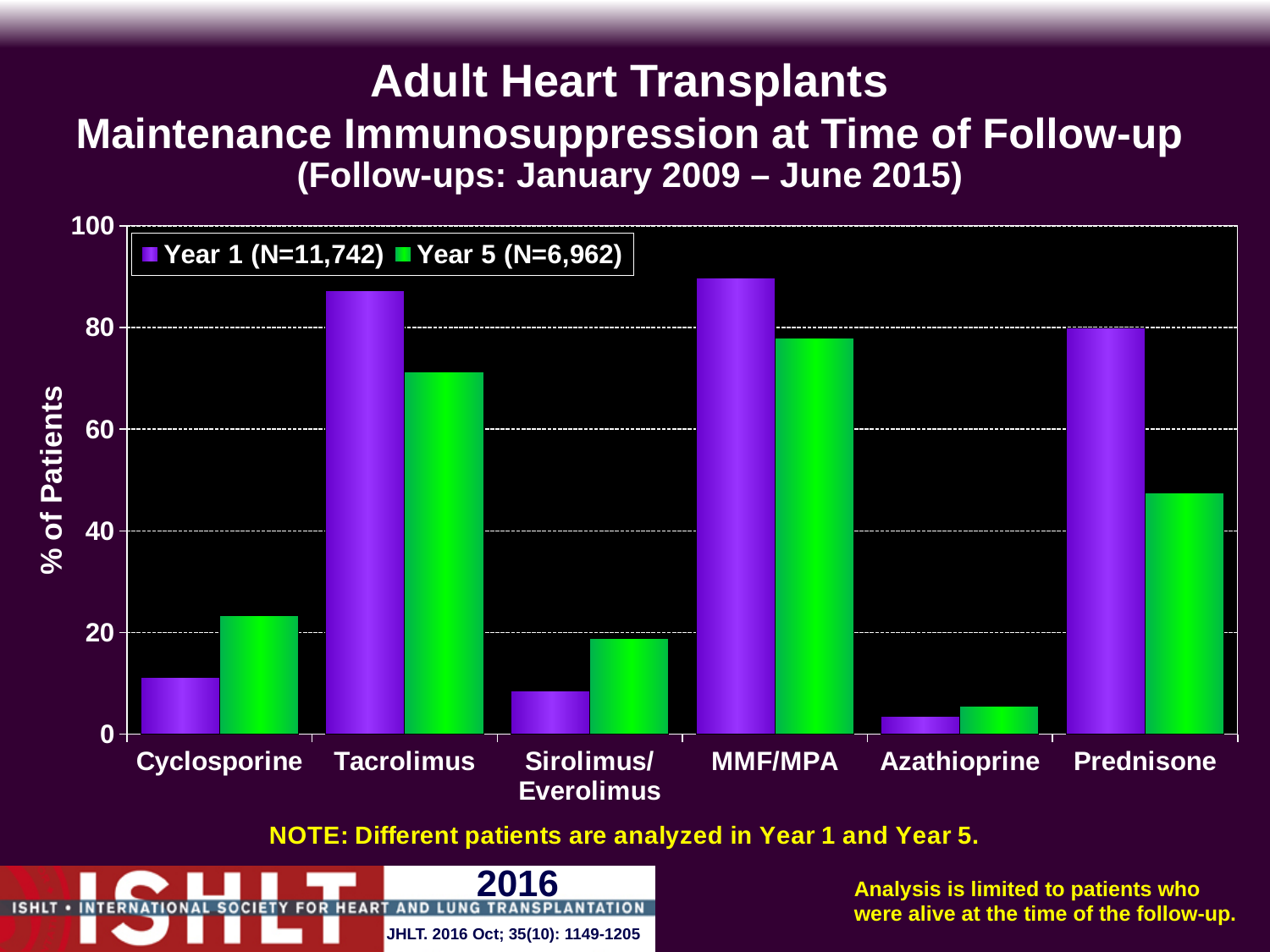
Which category has the highest Year 1 value? MMF/MPA Which category has the highest Year 5 value? MMF/MPA Which category has the lowest Year 1 value? Azathioprine How many series does the legend list? 2 Is the Year 1 value for Cyclosporine greater or less than 20? less For Prednisone, which is larger: the Year 1 value or the Year 5 value? Year 1 Which category has the lowest Year 5 value? Azathioprine What kind of chart is shown on the slide? bar chart How many drug categories are shown on the x axis? 6 Is the Year 5 value for Tacrolimus greater or less than 60? greater What is the N shown in the legend for Year 1? 11,742 Is the Year 5 value for Prednisone greater or less than 40? greater